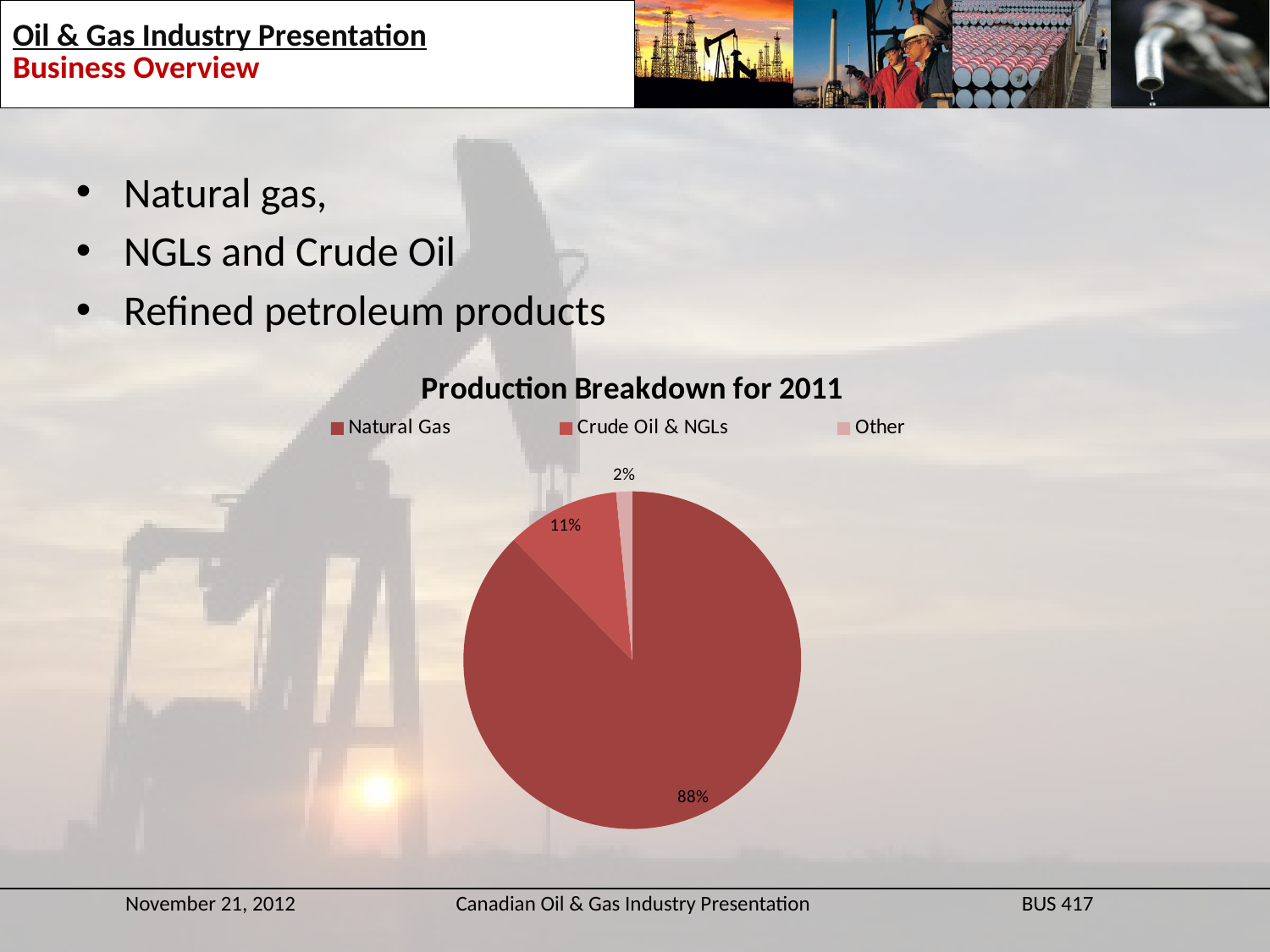
Which category has the smallest share of production? Other Which category has the largest share of production? Natural Gas What share of production does Other account for? 2% What is the difference in percentage points between the Natural Gas share and the Crude Oil & NGLs share? 77 percentage points What kind of chart is shown on the slide? pie chart Which is larger, the share for Crude Oil & NGLs or the share for Other? Crude Oil & NGLs How many entries does the legend list? 3 What share of production does Crude Oil & NGLs account for? 11% What is the difference in percentage points between the Crude Oil & NGLs share and the Other share? 9 percentage points How many categories does the pie chart show? 3 What is the title of the chart? Production Breakdown for 2011 What share of production does Natural Gas account for? 88%